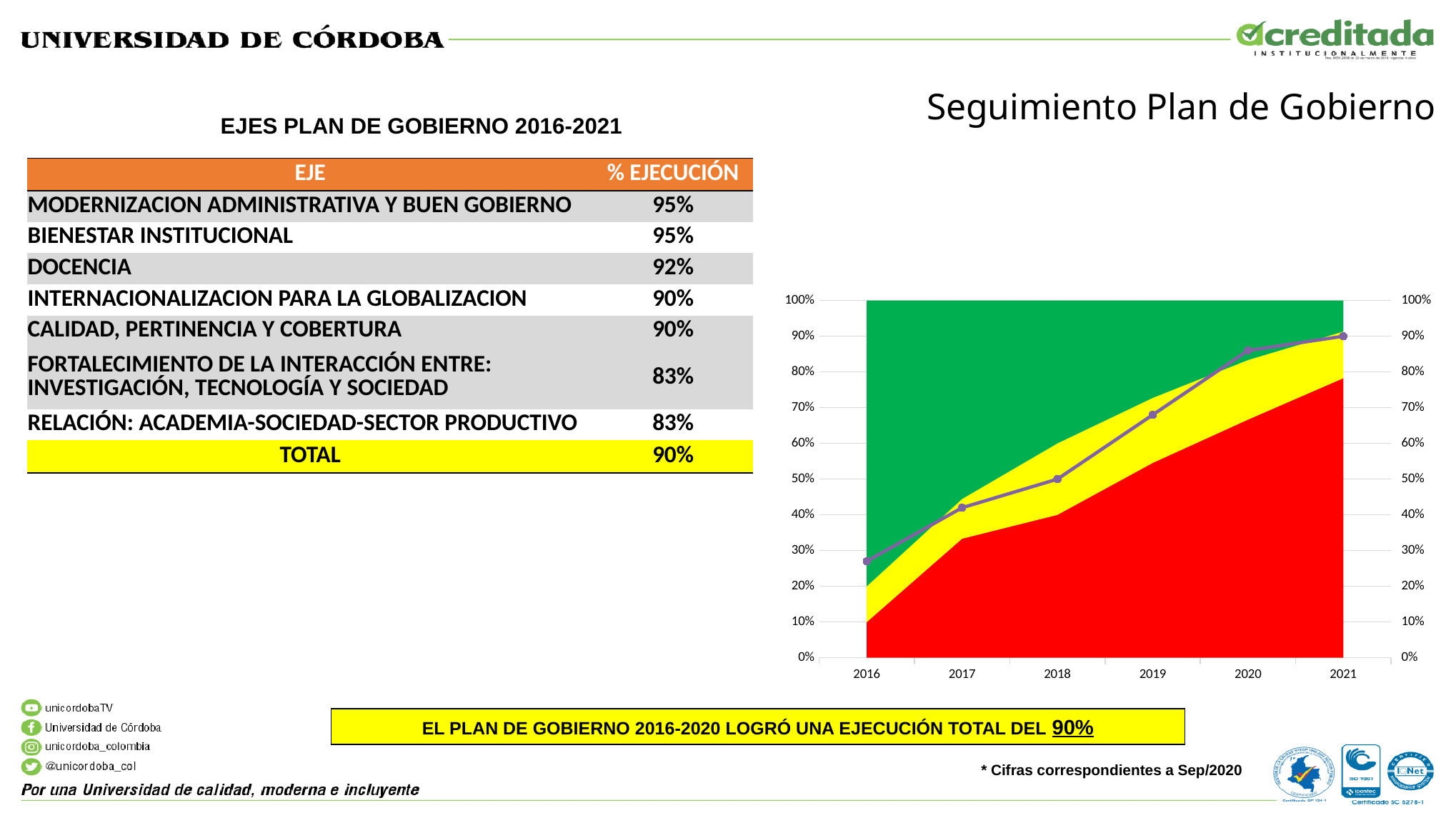
What kind of chart is shown on the right side of the slide? a combination area and line chart (stacked areas with a line) How many years are shown on the x axis of the chart? 6 What three colours are used for the stacked areas in the chart? red, yellow and green Is the value of the purple line in 2016 greater or less than 20%? greater In which year is the purple line at its lowest point? 2016 Does the purple line in the chart rise or fall from 2016 to 2021? rise Is the purple line value higher in 2019 or in 2017? 2019 Is the value of the purple line in 2020 greater or less than 80%? greater Is the value of the purple line in 2017 greater or less than 50%? less In which year is the purple line at its highest point? 2021 Which years does the chart's x axis span? 2016 to 2021